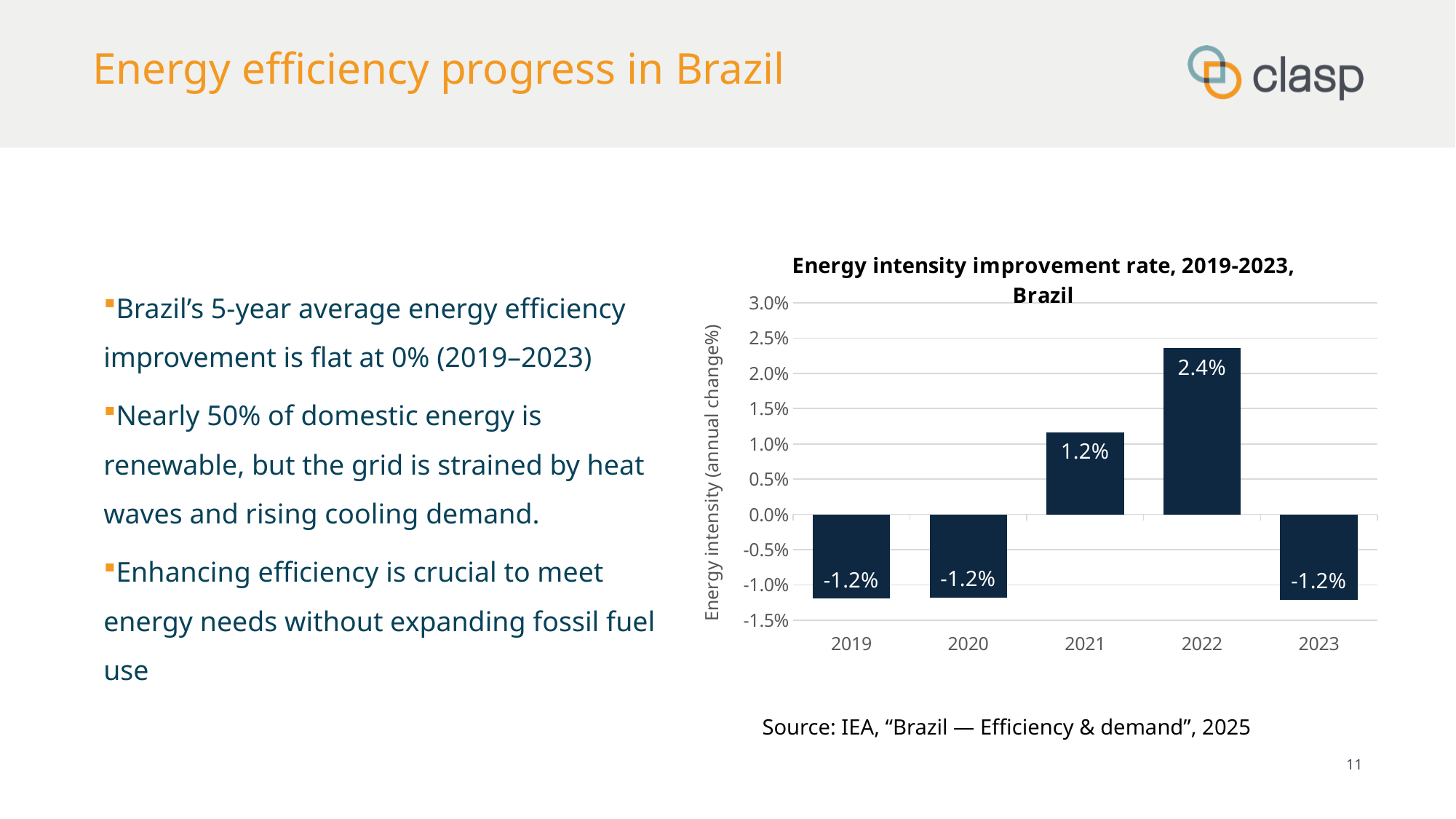
Is the value for 2022 greater or less than 2.0%? greater What is the energy intensity improvement rate for 2023? -1.2% What kind of chart is shown on the slide? Bar chart How many years are shown on the x axis of the chart? 5 What is the label of the vertical axis of the chart? Energy intensity (annual change%) What is the energy intensity improvement rate for 2019? -1.2% What is the title of the chart? Energy intensity improvement rate, 2019-2023, Brazil What is the difference between the values for 2022 and 2021? 1.2% Which year has the highest energy intensity improvement rate? 2022 Which is larger, the value for 2021 or the value for 2022? 2022 What is the energy intensity improvement rate for 2021? 1.2% What is the energy intensity improvement rate for 2022? 2.4%